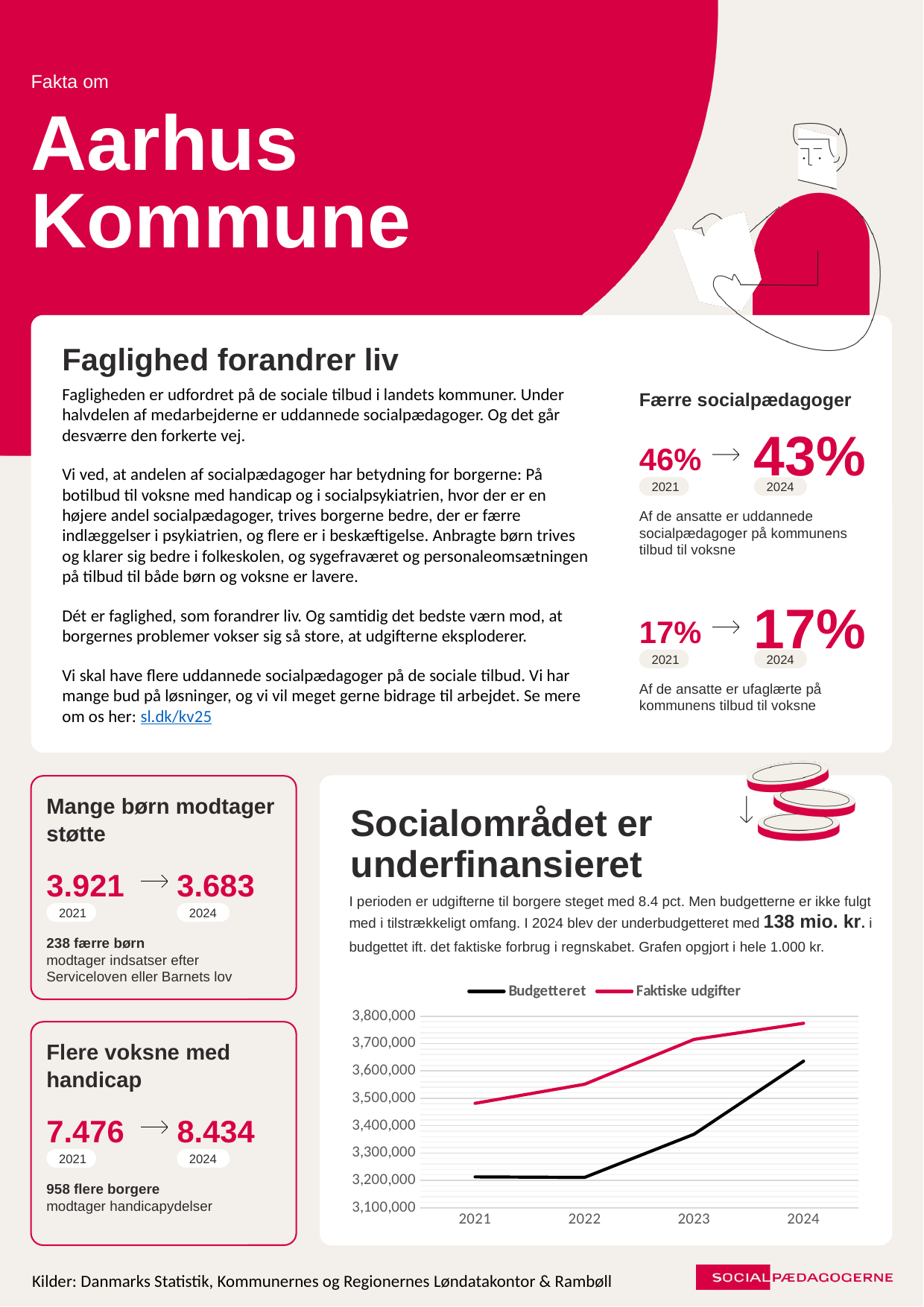
Does the Budgetteret series rise or fall from 2022 to 2024? rise How many series does the chart legend list? 2 Is the value for Faktiske udgifter in 2022 greater or less than 3,500,000? greater Is the value for Budgetteret in 2021 greater or less than 3,300,000? less What kind of chart is shown on the slide? Line chart Which series has the higher value in 2024, Budgetteret or Faktiske udgifter? Faktiske udgifter In which year is the Faktiske udgifter series at its highest? 2024 Is the value for Budgetteret in 2024 greater or less than 3,600,000? greater What is the lowest value shown on the chart's y axis? 3,100,000 Which series is drawn in red in the chart? Faktiske udgifter How many years are plotted along the x axis of the chart? 4